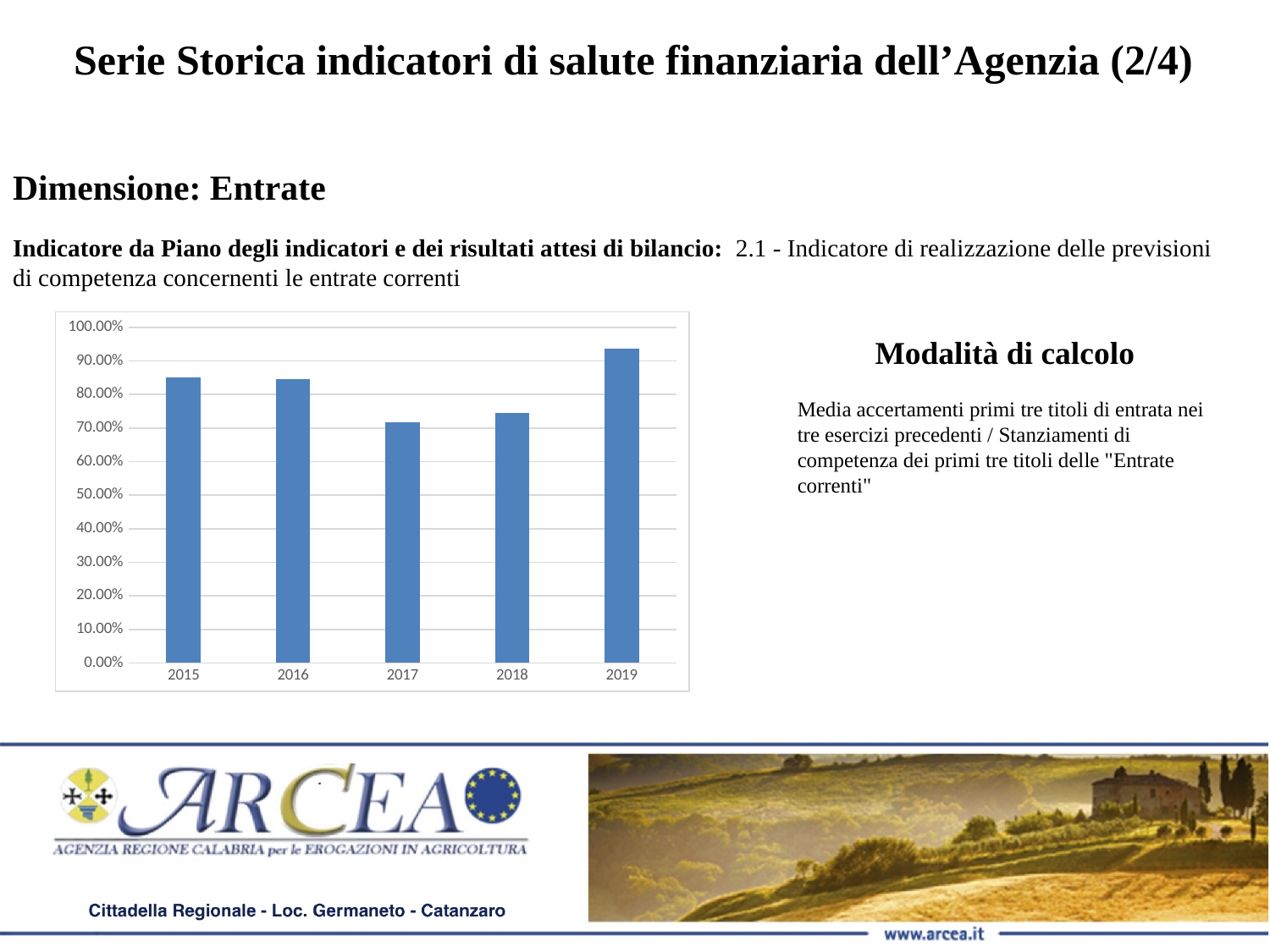
Is the value for 2017 greater or less than 70.00%? greater Is the value for 2015 greater or less than 80.00%? greater Which year has the lowest value in the chart? 2017 What kind of chart is shown on the slide? bar chart Which is larger, the value for 2018 or the value for 2019? 2019 What is the first year shown on the x axis of the chart? 2015 Is the value for 2019 greater or less than 90.00%? greater Which is larger, the value for 2015 or the value for 2017? 2015 Which year has the highest value in the chart? 2019 How many years are shown on the x axis of the chart? 5